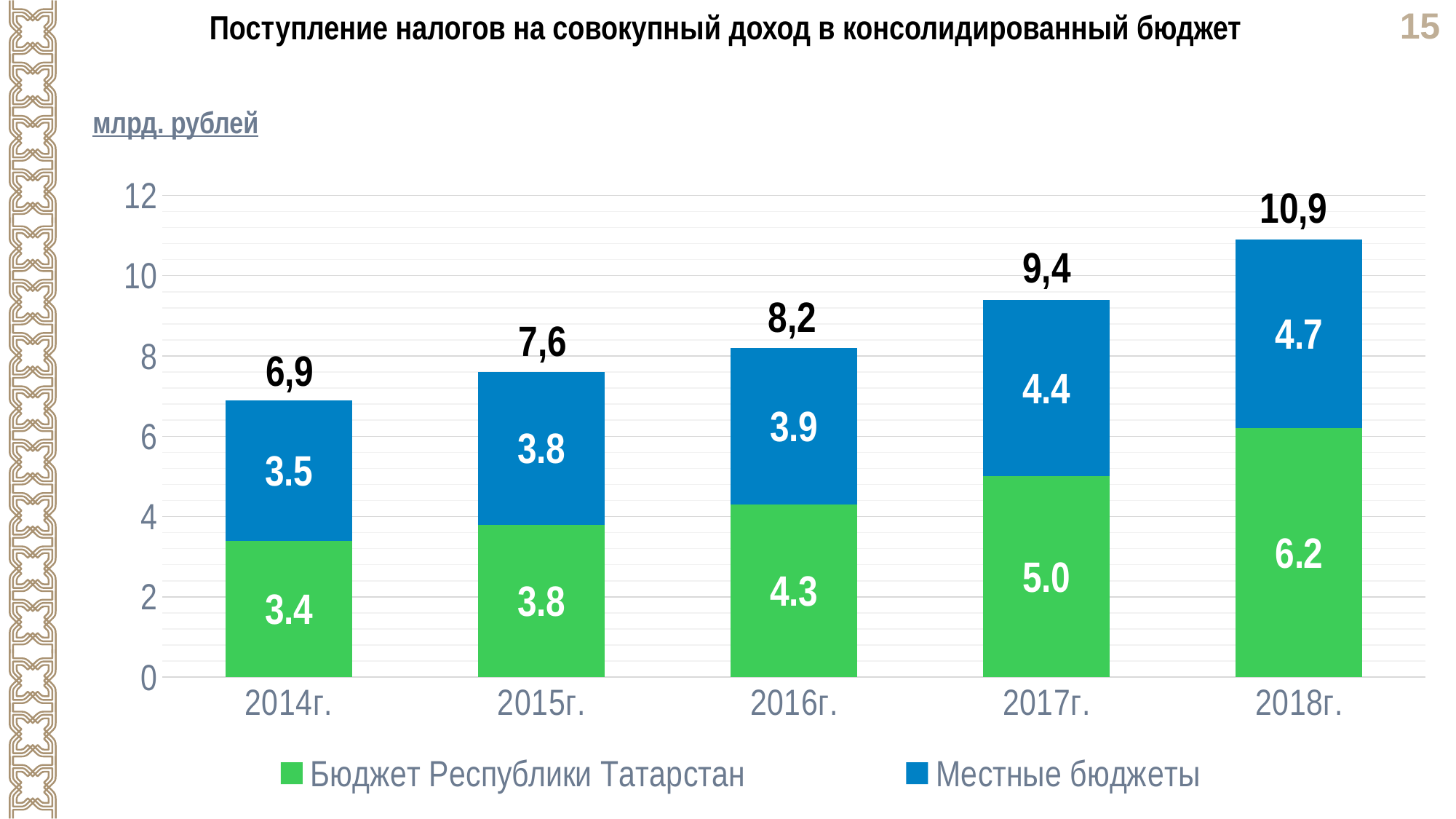
What is the value for Местные бюджеты in 2018г.? 4.7 What is the value for Бюджет Республики Татарстан in 2016г.? 4.3 Do the total values rise or fall from 2014г. to 2018г.? Rise How many series does the legend list? 2 What unit is stated above the chart? млрд. рублей Which year has the highest total? 2018г. Which year has the lowest value for Бюджет Республики Татарстан? 2014г. Which is larger in 2017г.: Бюджет Республики Татарстан or Местные бюджеты? Бюджет Республики Татарстан What is the total of the stacked bar for 2017г.? 9,4 What is the difference between the Бюджет Республики Татарстан value in 2018г. and in 2014г.? 2.8 What kind of chart is shown on the slide? Stacked bar chart How many years are shown on the x axis? 5